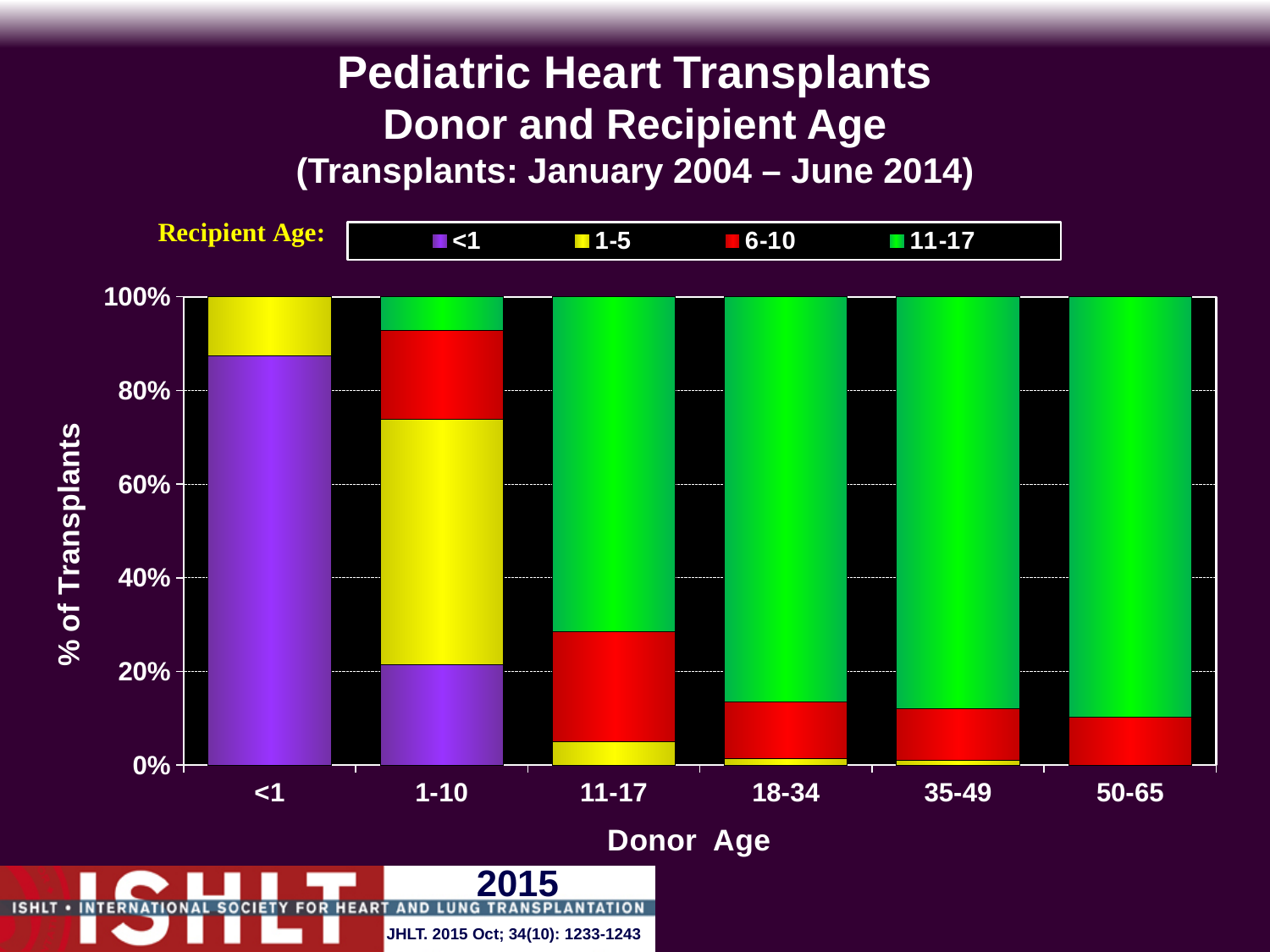
Which recipient age group is shown in purple in the legend? <1 Which donor age category has the largest share of <1 recipients? <1 What is the label of the y axis? % of Transplants Is the share of 1-5 recipients for donor age 1-10 greater or less than 40%? greater Does the share of 11-17 recipients rise or fall as donor age increases along the x axis? rise Is the share of 6-10 recipients for donor age 50-65 greater or less than 20%? less Which has a larger share of 11-17 recipients: donor age 11-17 or donor age 50-65? 50-65 Is the share of 11-17 recipients for donor age 11-17 greater or less than 60%? greater What kind of chart is shown on the slide? stacked bar chart How many donor age categories are shown on the x axis? 6 How many recipient age groups does the legend list? 4